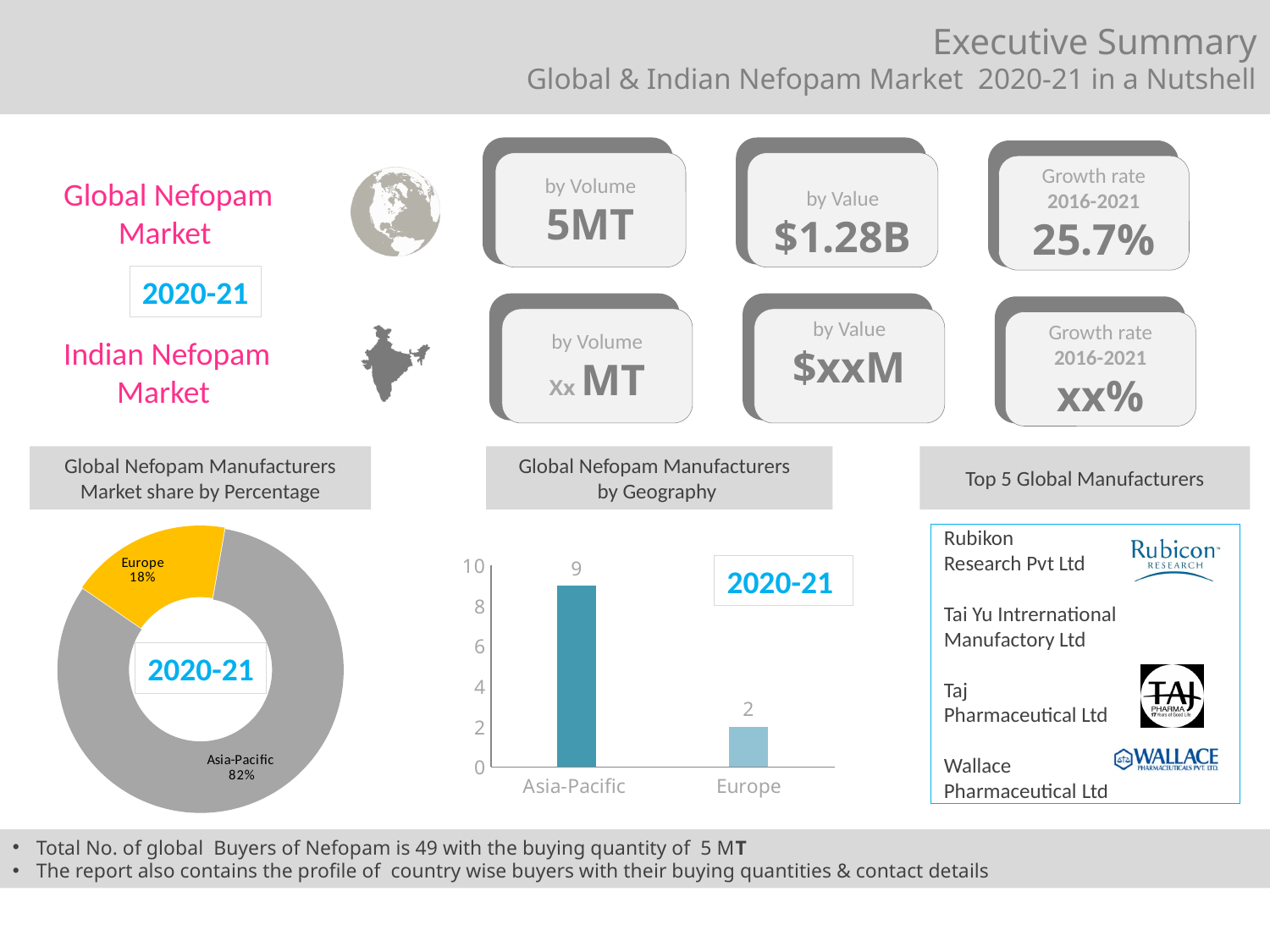
In the 'Global Nefopam Manufacturers by Geography' chart, what is the value for Europe? 2 What kind of chart is the 'Global Nefopam Manufacturers by Geography' chart? Bar chart In the 'Global Nefopam Manufacturers Market share by Percentage' chart, what is the share for Asia-Pacific? 82% In the 'Global Nefopam Manufacturers by Geography' chart, what year label is shown on the chart? 2020-21 In the 'Global Nefopam Manufacturers Market share by Percentage' chart, how many regions are shown? 2 In the 'Global Nefopam Manufacturers Market share by Percentage' chart, what is the share for Europe? 18% In the 'Global Nefopam Manufacturers Market share by Percentage' chart, what is the difference between the Asia-Pacific and Europe shares? 64% In the 'Global Nefopam Manufacturers by Geography' chart, which region has the lowest value? Europe What kind of chart is the 'Global Nefopam Manufacturers Market share by Percentage' chart? Pie (donut) chart In the 'Global Nefopam Manufacturers Market share by Percentage' chart, which region has the largest share? Asia-Pacific In the 'Global Nefopam Manufacturers by Geography' chart, what is the difference between the Asia-Pacific and Europe values? 7 In the 'Global Nefopam Manufacturers by Geography' chart, what is the value for Asia-Pacific? 9